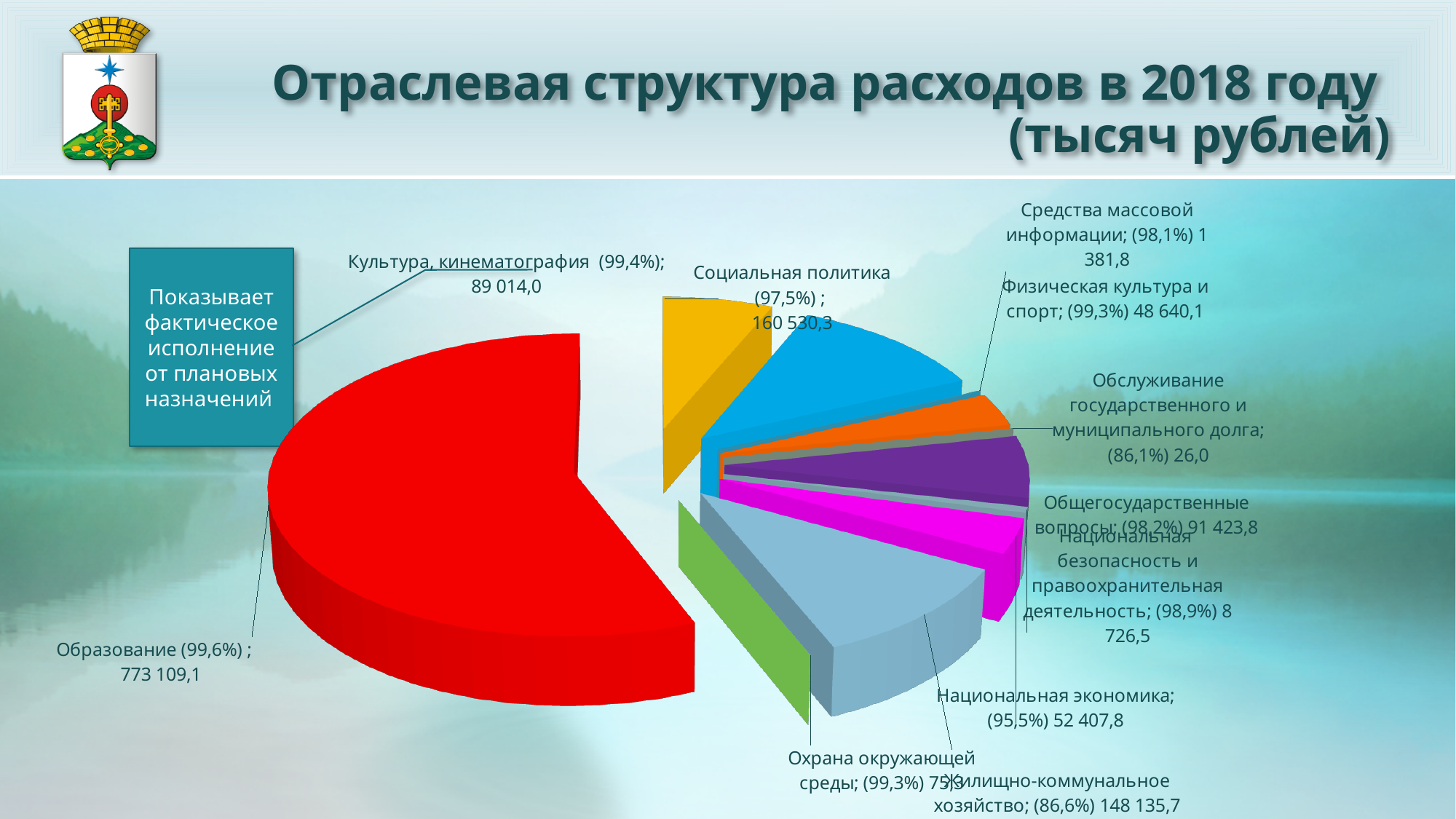
What kind of chart is shown on the slide? Pie chart Which category has the largest value? Образование What is the difference between the values for Социальная политика and Жилищно-коммунальное хозяйство? 12 394,6 What execution percentage is shown for Национальная экономика? 95,5% Which category has the smallest value? Обслуживание государственного и муниципального долга How many categories are labelled on the pie chart? 11 What is the title of the chart? Отраслевая структура расходов в 2018 году (тысяч рублей) Which is larger: the value for Общегосударственные вопросы or for Культура, кинематография? Общегосударственные вопросы What is the value for Обслуживание государственного и муниципального долга? 26,0 What is the value for Жилищно-коммунальное хозяйство? 148 135,7 What is the value for Образование? 773 109,1 What is the value for Социальная политика? 160 530,3